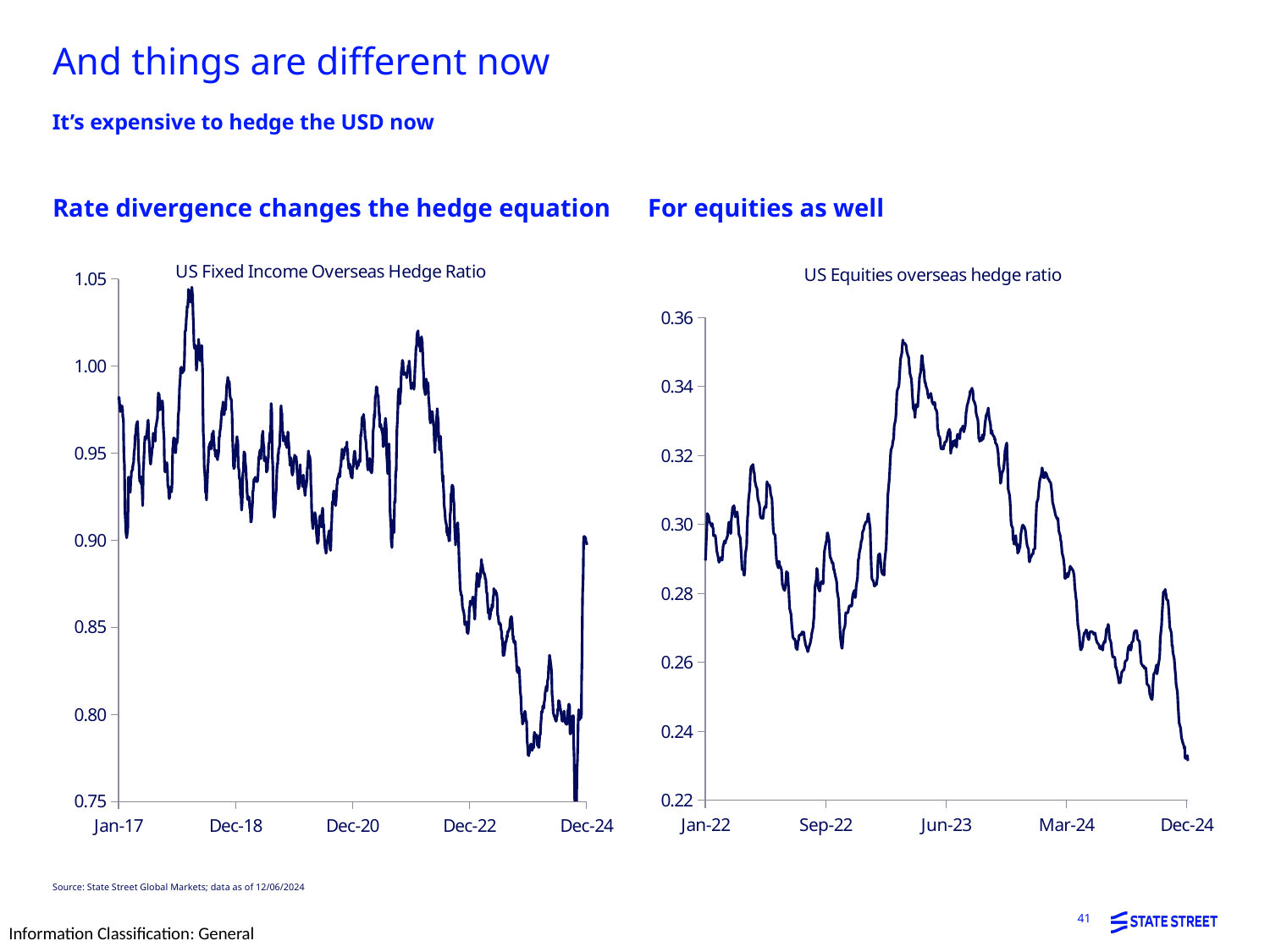
In the US Equities overseas hedge ratio chart, does the hedge ratio rise or fall from Jun-23 to Dec-24? Fall In the US Equities overseas hedge ratio chart, is the value at Dec-24 greater or less than 0.24? less What kind of chart is the US Equities overseas hedge ratio chart on the right? Line chart In the US Fixed Income Overseas Hedge Ratio chart, is the peak value reached in 2018 greater or less than 1.00? greater What is the title of the chart on the right? US Equities overseas hedge ratio How many charts are shown on the slide? 2 What kind of chart is the US Fixed Income Overseas Hedge Ratio chart on the left? Line chart In the US Fixed Income Overseas Hedge Ratio chart, is the value at Dec-22 greater or less than 0.90? less In the US Fixed Income Overseas Hedge Ratio chart, does the hedge ratio overall rise or fall from Jan-17 to Dec-24? Fall In the US Fixed Income Overseas Hedge Ratio chart, what is the highest value shown on the y axis? 1.05